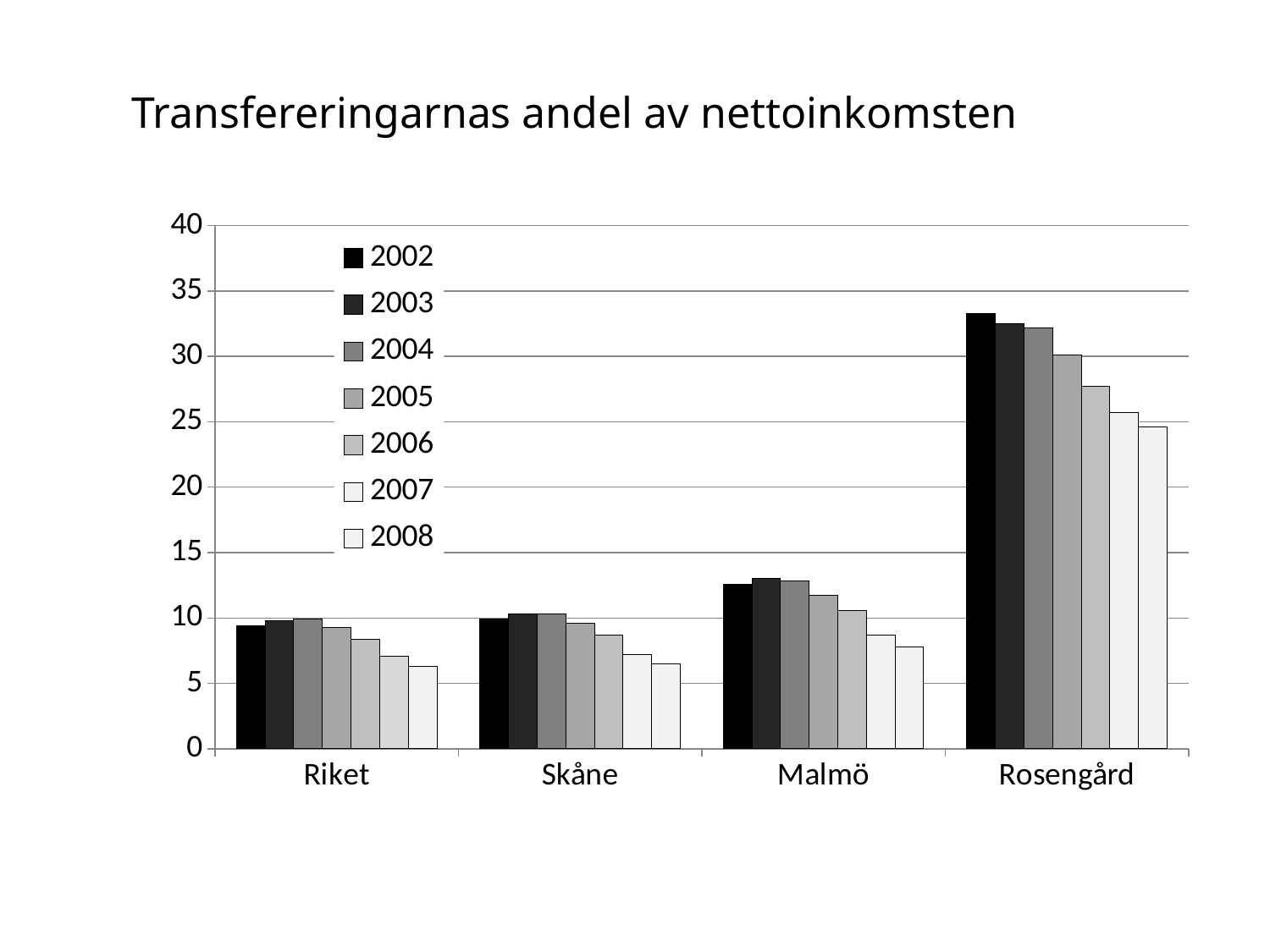
How many series does the legend list? 7 What is the title of the chart? Transfereringarnas andel av nettoinkomsten For Rosengård, which year has the lowest value? 2008 How many categories are shown on the x axis? 4 Is the value for Rosengård in 2002 greater or less than 30? greater Is the value for Rosengård in 2008 greater or less than 20? greater Is the value for Malmö in 2008 greater or less than 10? less Which category has the highest values in the chart? Rosengård Do the values for Rosengård rise or fall from 2002 to 2008? fall Which is larger, the 2002 value for Malmö or the 2002 value for Riket? Malmö For Rosengård, which year has the highest value? 2002 What kind of chart is shown on the slide? bar chart